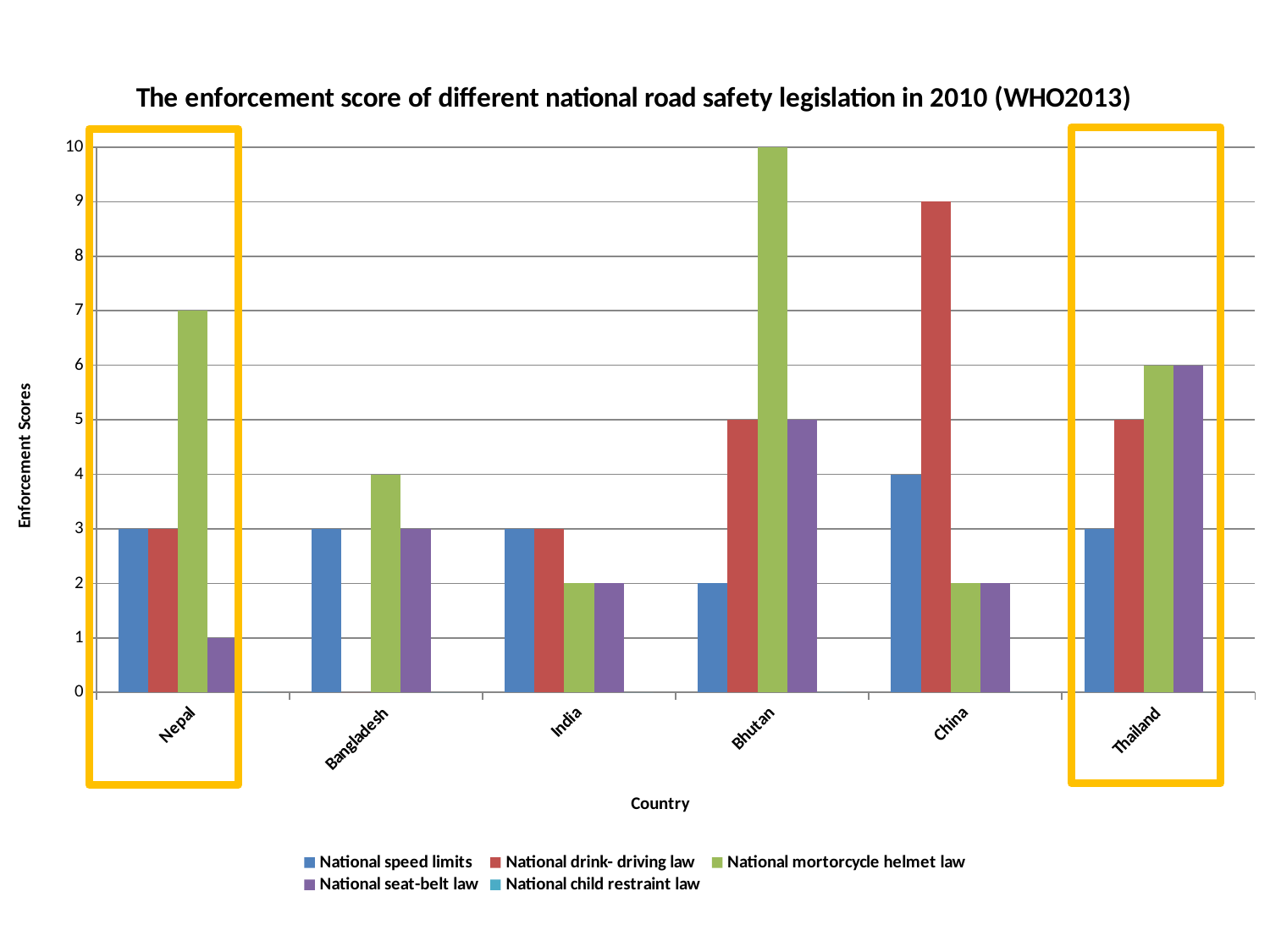
What is the title of the chart? The enforcement score of different national road safety legislation in 2010 (WHO2013) What is the difference between the National motorcycle helmet law score in Bhutan and in Nepal? 3 What is the enforcement score for the National drink-driving law in China? 9 What is the enforcement score for the National motorcycle helmet law in Bhutan? 10 How many series does the legend list? 5 Which country has the highest enforcement score for the National drink-driving law? China Which is larger: the National speed limits score for China or for Thailand? China What type of chart is shown on the slide? bar chart Is the National drink-driving law score for China greater or less than 5? greater How many countries are shown on the x axis? 6 What is the enforcement score for the National seat-belt law in Nepal? 1 Which country has the highest enforcement score for the National motorcycle helmet law? Bhutan